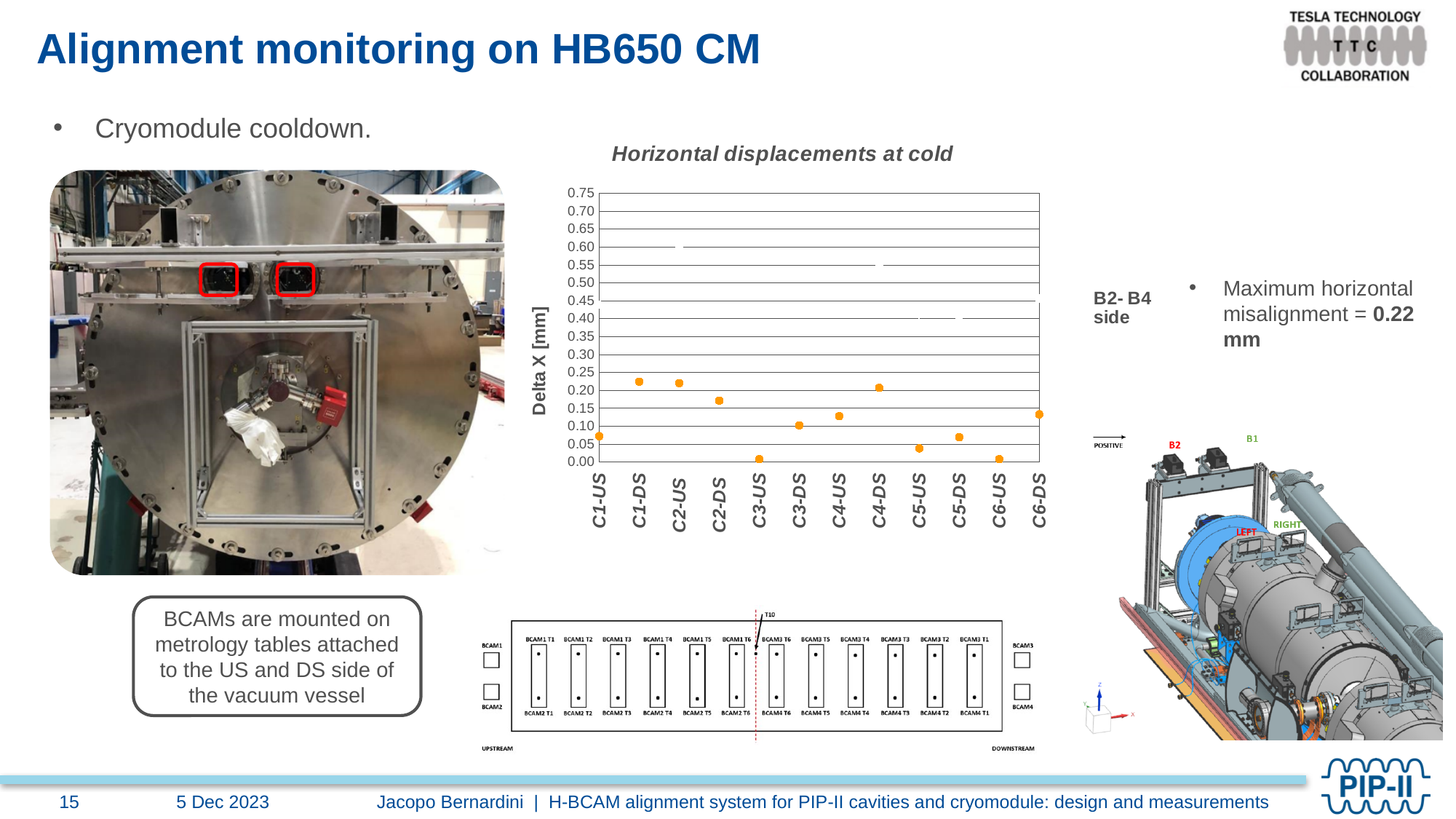
In the 'Horizontal displacements at cold' chart, is the value for C2-DS greater or less than 0.20? less What is the label of the vertical axis in the 'Horizontal displacements at cold' chart? Delta X [mm] In the 'Horizontal displacements at cold' chart, which has the larger value, C2-DS or C5-DS? C2-DS In the 'Horizontal displacements at cold' chart, is the value for C3-US greater or less than 0.05? less In the 'Horizontal displacements at cold' chart, which has the larger value, C4-DS or C5-US? C4-DS What is the title of the chart on the slide? Horizontal displacements at cold In the 'Horizontal displacements at cold' chart, is the value for C6-DS greater or less than 0.10? greater How many categories are plotted along the x axis of the 'Horizontal displacements at cold' chart? 12 What kind of chart is 'Horizontal displacements at cold'? scatter chart In the 'Horizontal displacements at cold' chart, which has the larger value, C1-DS or C3-US? C1-DS